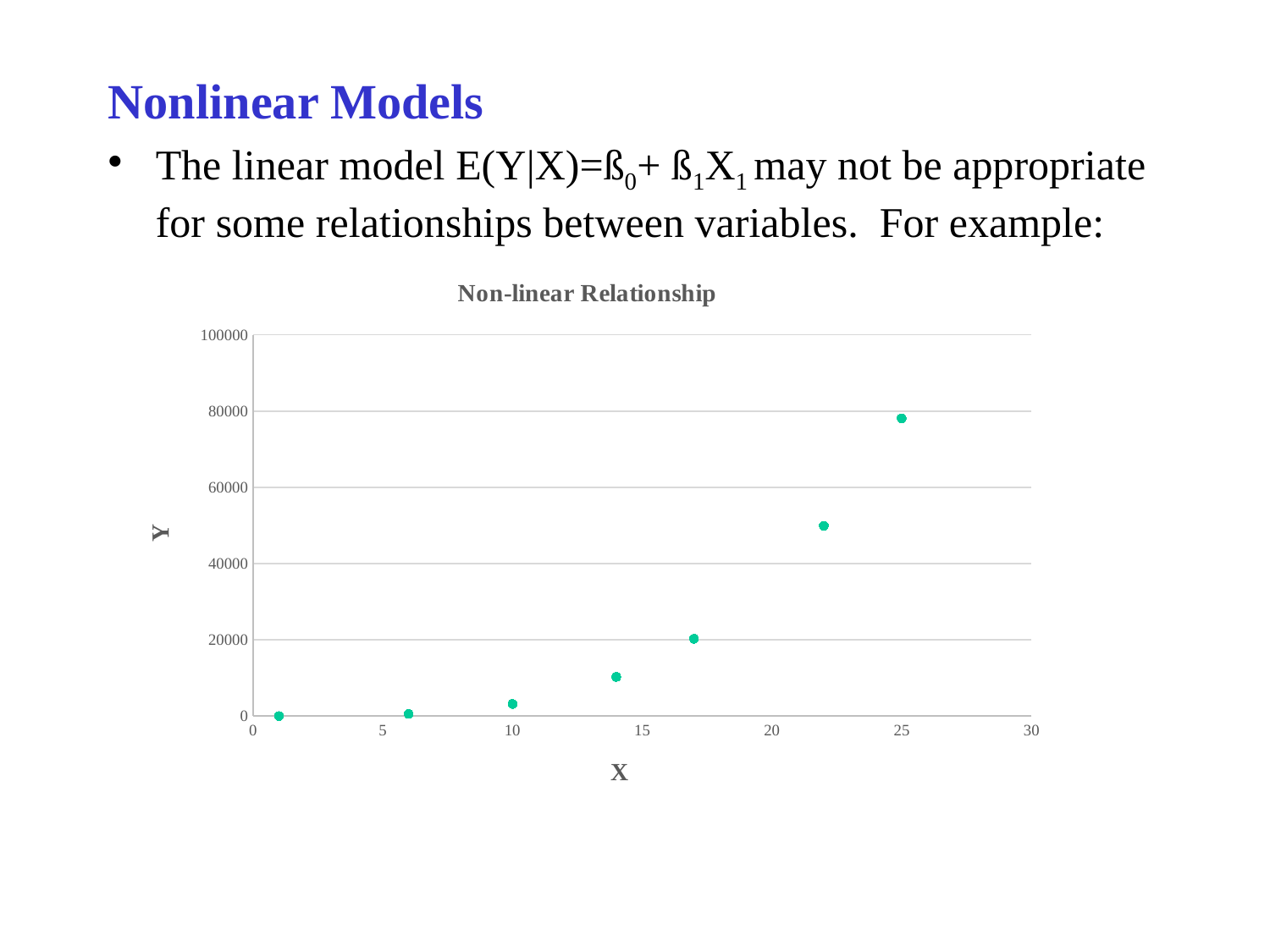
What kind of chart is shown on the slide? scatter plot What is the title of the chart? Non-linear Relationship Is the Y value of the point near X = 22 greater or less than 40000? greater Is the Y value of the point near X = 22 greater or less than 60000? less Is the Y value of the rightmost point (near X = 25) greater or less than 60000? greater How many data points are plotted in the chart? 7 What is the highest value shown on the vertical axis? 100000 Do the Y values rise or fall as X increases along the x axis? rise Which point has the larger Y value, the one near X = 22 or the one near X = 25? the one near X = 25 What is the label on the vertical axis of the chart? Y